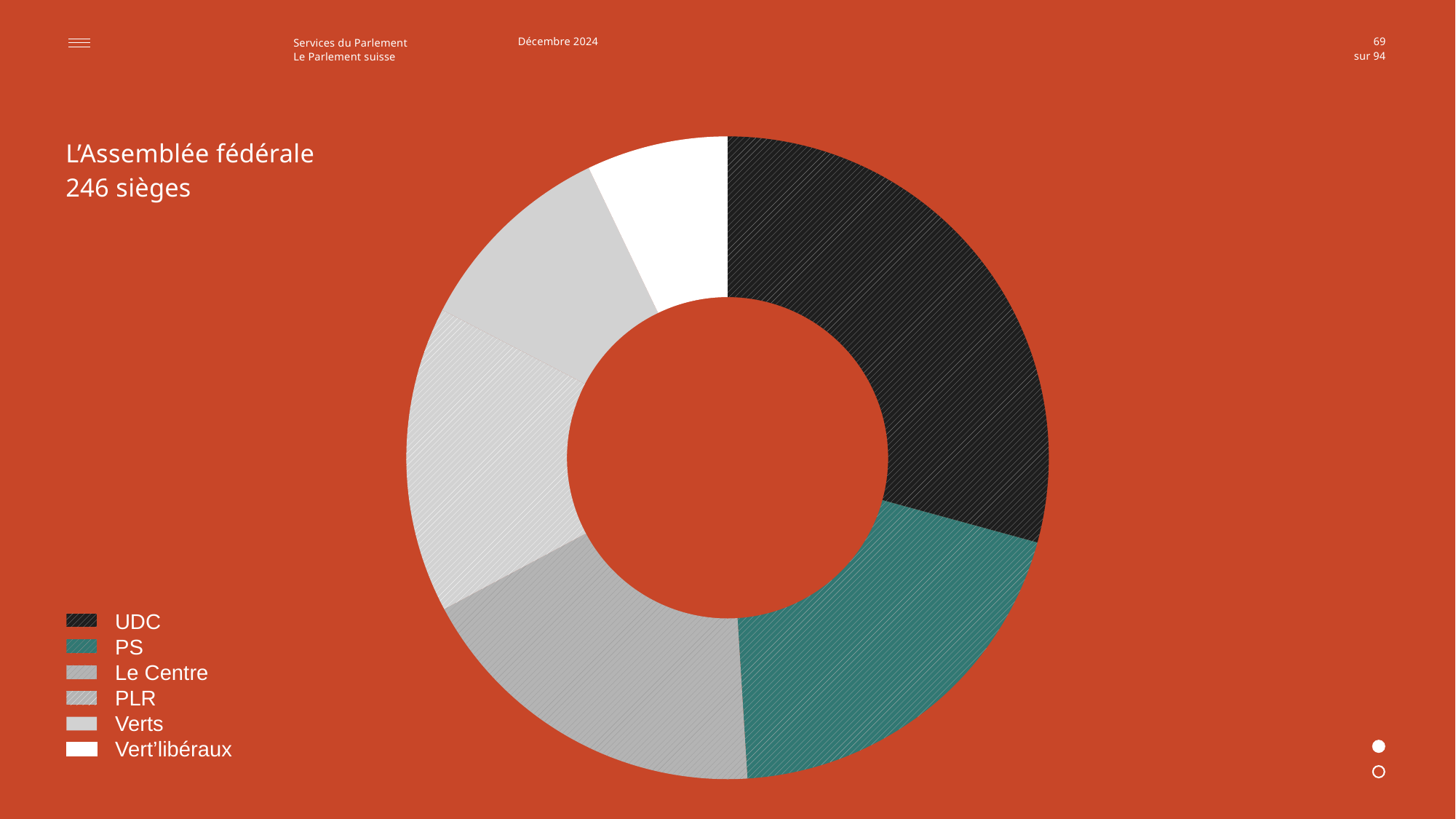
What is the title of the chart? L'Assemblée fédérale 246 sièges Which has the larger share of the chart, PLR or Vert'libéraux? PLR Which has the larger share of the chart, Le Centre or Verts? Le Centre Which has the larger share of the chart, Verts or Vert'libéraux? Verts Which party is shown in teal (green) in the chart? PS What kind of chart is shown on the slide? Pie chart (donut) How many parties does the legend of the chart list? 6 Which party has the largest share of the chart? UDC Which party has the smallest share of the chart? Vert'libéraux